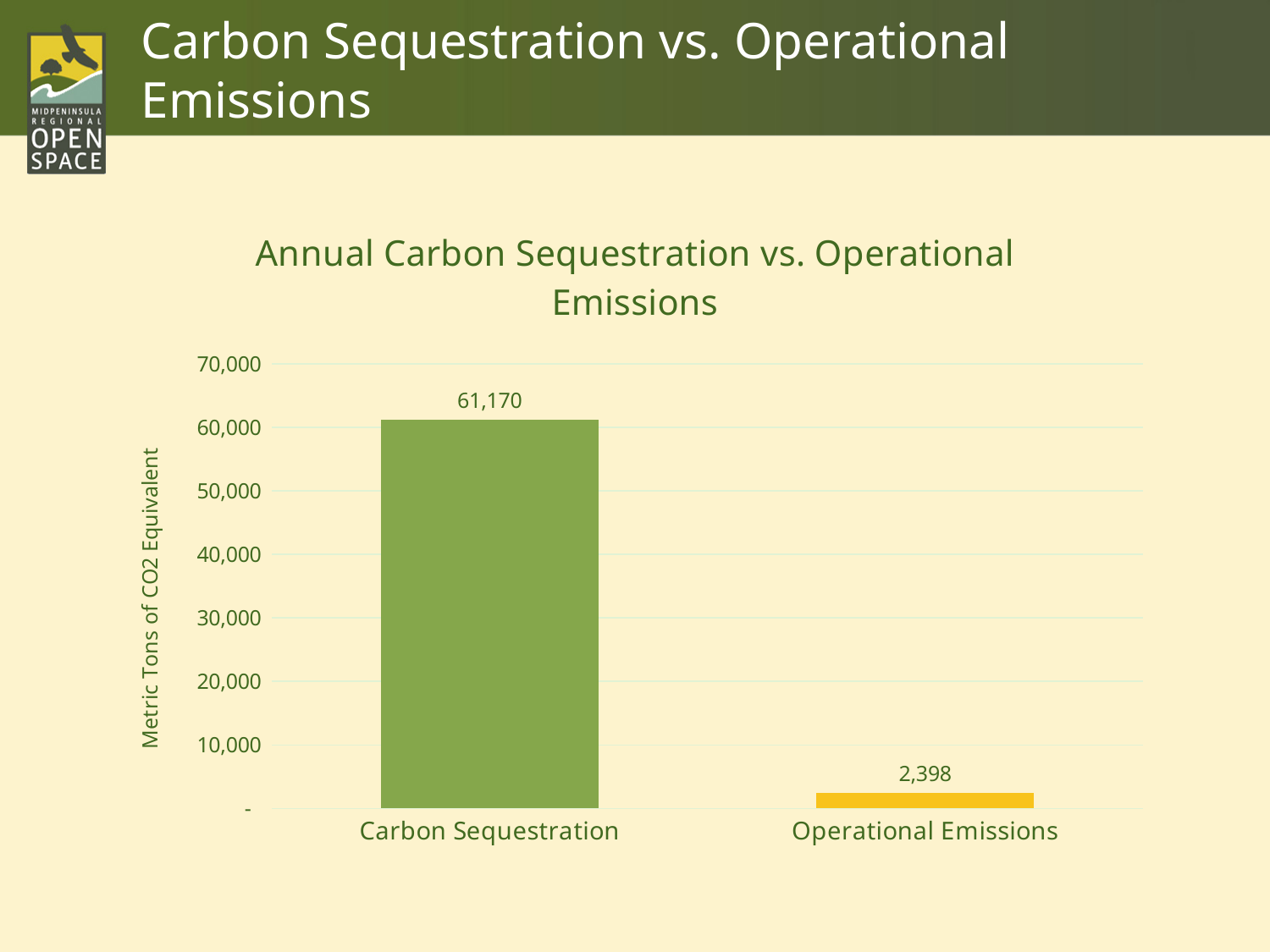
Which is larger, Carbon Sequestration or Operational Emissions? Carbon Sequestration What kind of chart is shown on the slide? Bar chart Is the value for Operational Emissions greater or less than 10,000? less What is the value for Carbon Sequestration? 61,170 Which category has the highest value? Carbon Sequestration What is the value for Operational Emissions? 2,398 What is the label on the vertical axis? Metric Tons of CO2 Equivalent Which category has the lowest value? Operational Emissions How many categories are shown on the chart? 2 Is the value for Carbon Sequestration greater or less than 50,000? greater What is the difference between Carbon Sequestration and Operational Emissions? 58,772 What is the title of the chart? Annual Carbon Sequestration vs. Operational Emissions